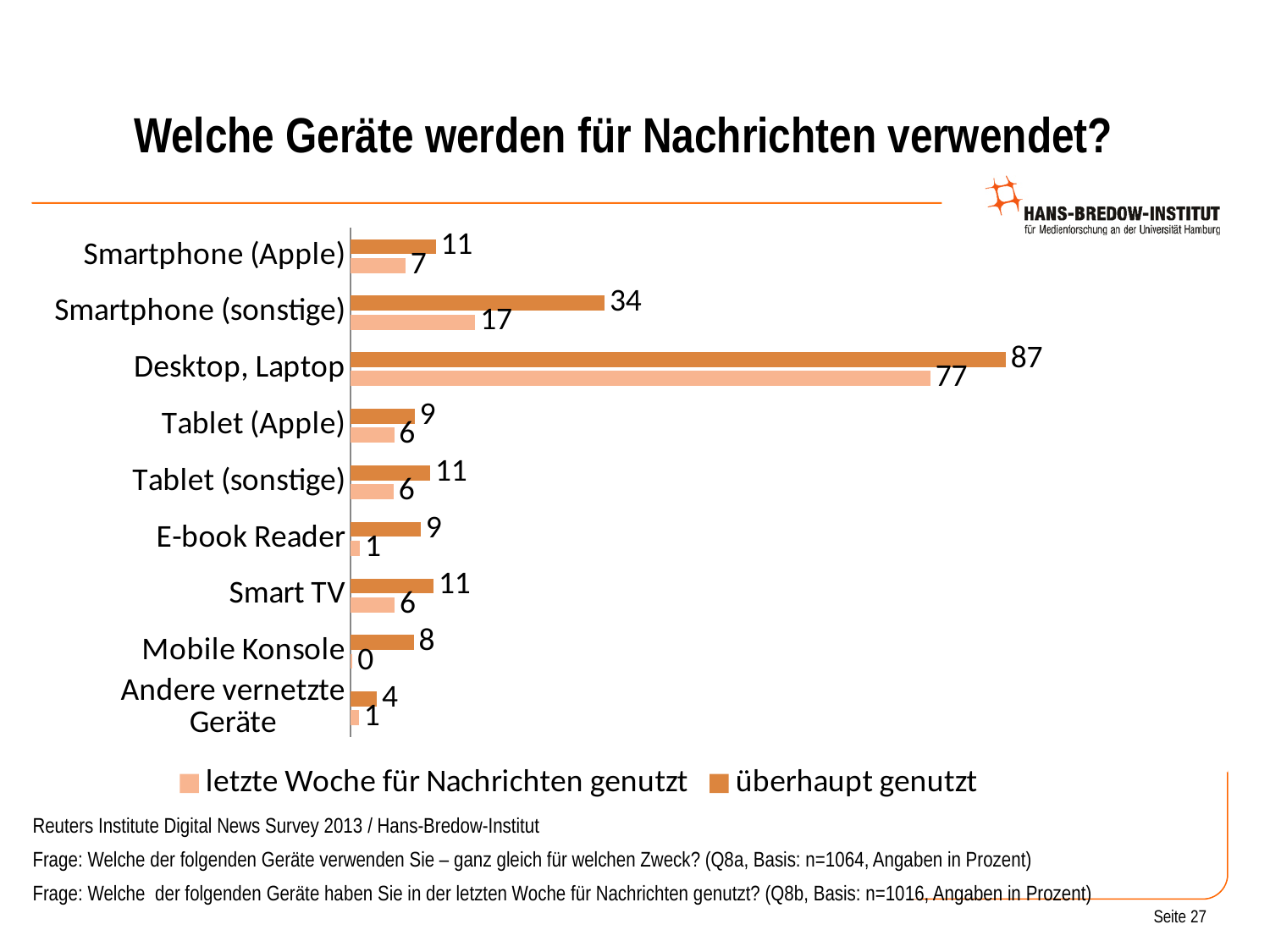
What is the value for "letzte Woche für Nachrichten genutzt" for Mobile Konsole? 0 How many device categories are shown in the chart? 9 Which category has the lowest value for "überhaupt genutzt"? Andere vernetzte Geräte What is the value for "letzte Woche für Nachrichten genutzt" for Smartphone (sonstige)? 17 How many series does the legend list? 2 What kind of chart is shown on the slide? Bar chart What is the value for "überhaupt genutzt" for Desktop, Laptop? 87 What is the difference between "überhaupt genutzt" and "letzte Woche für Nachrichten genutzt" for Smartphone (sonstige)? 17 Which series is shown in the darker orange colour? überhaupt genutzt Which is larger: the "überhaupt genutzt" value for Smartphone (Apple) or for Smartphone (sonstige)? Smartphone (sonstige) What is the difference between "überhaupt genutzt" and "letzte Woche für Nachrichten genutzt" for Desktop, Laptop? 10 Which category has the highest value for "überhaupt genutzt"? Desktop, Laptop